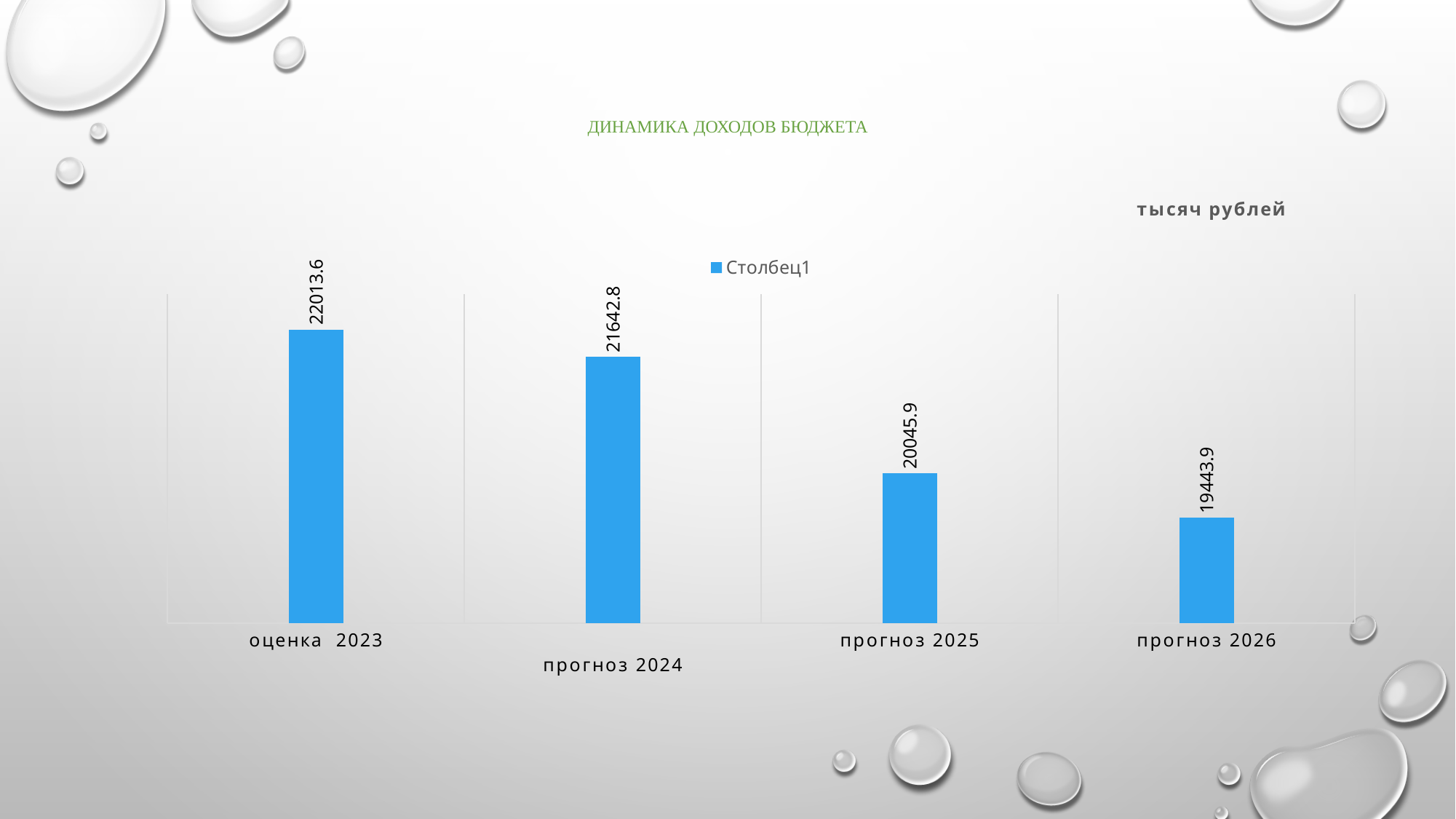
What is the difference between the values for прогноз 2025 and прогноз 2026? 602 Which is larger, the value for прогноз 2024 or the value for прогноз 2025? прогноз 2024 Do the values rise or fall from оценка 2023 to прогноз 2026? Fall How many categories are shown on the x axis? 4 Which category has the highest value? оценка 2023 What is the value for прогноз 2026? 19443.9 What is the difference between the values for оценка 2023 and прогноз 2024? 370.8 What is the value for прогноз 2024? 21642.8 What is the value for оценка 2023? 22013.6 What kind of chart is shown on the slide? Bar chart What is the value for прогноз 2025? 20045.9 Which category has the lowest value? прогноз 2026